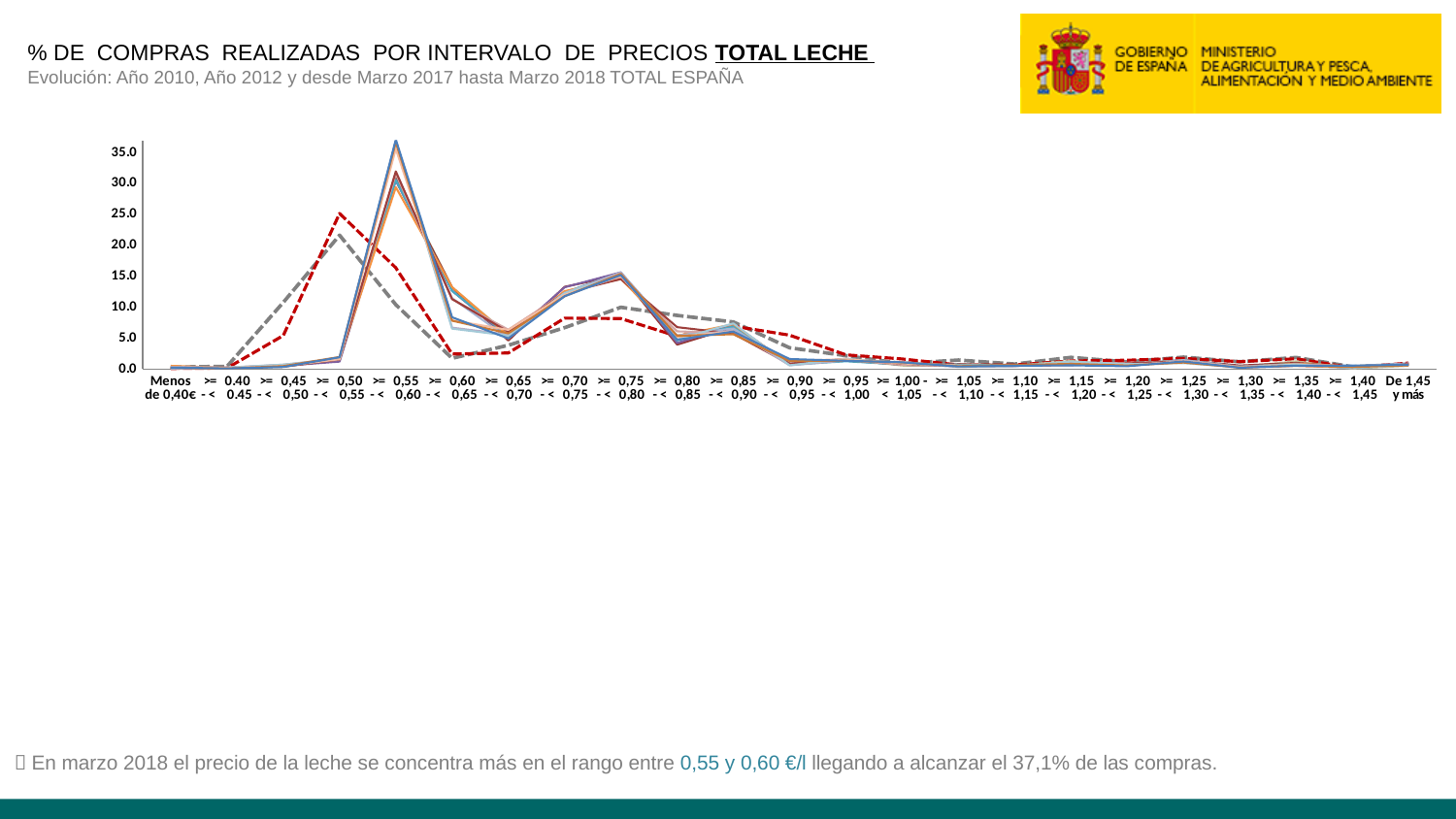
Is the value of the grey dashed line in the >= 0,50 - < 0,55 interval greater or less than 15.0? greater Is the peak value of the solid lines in the >= 0,55 - < 0,60 interval greater or less than 35.0? greater Do the values of the lines generally rise or fall from the >= 0,55 - < 0,60 interval toward the right end of the x axis? fall How many price intervals are shown along the x axis of the chart? 23 What is the first price interval label on the x axis of the chart? Menos de 0,40€ In which price interval do the solid lines reach their highest value? >= 0,55 - < 0,60 What is the highest value shown on the y axis of the chart? 35.0 Are the values of the solid lines in the >= 0,75 - < 0,80 interval greater or less than 10.0? greater What kind of chart is shown on the slide? line chart Which is larger for the solid lines: the value in the >= 0,55 - < 0,60 interval or the value in the >= 0,75 - < 0,80 interval? >= 0,55 - < 0,60